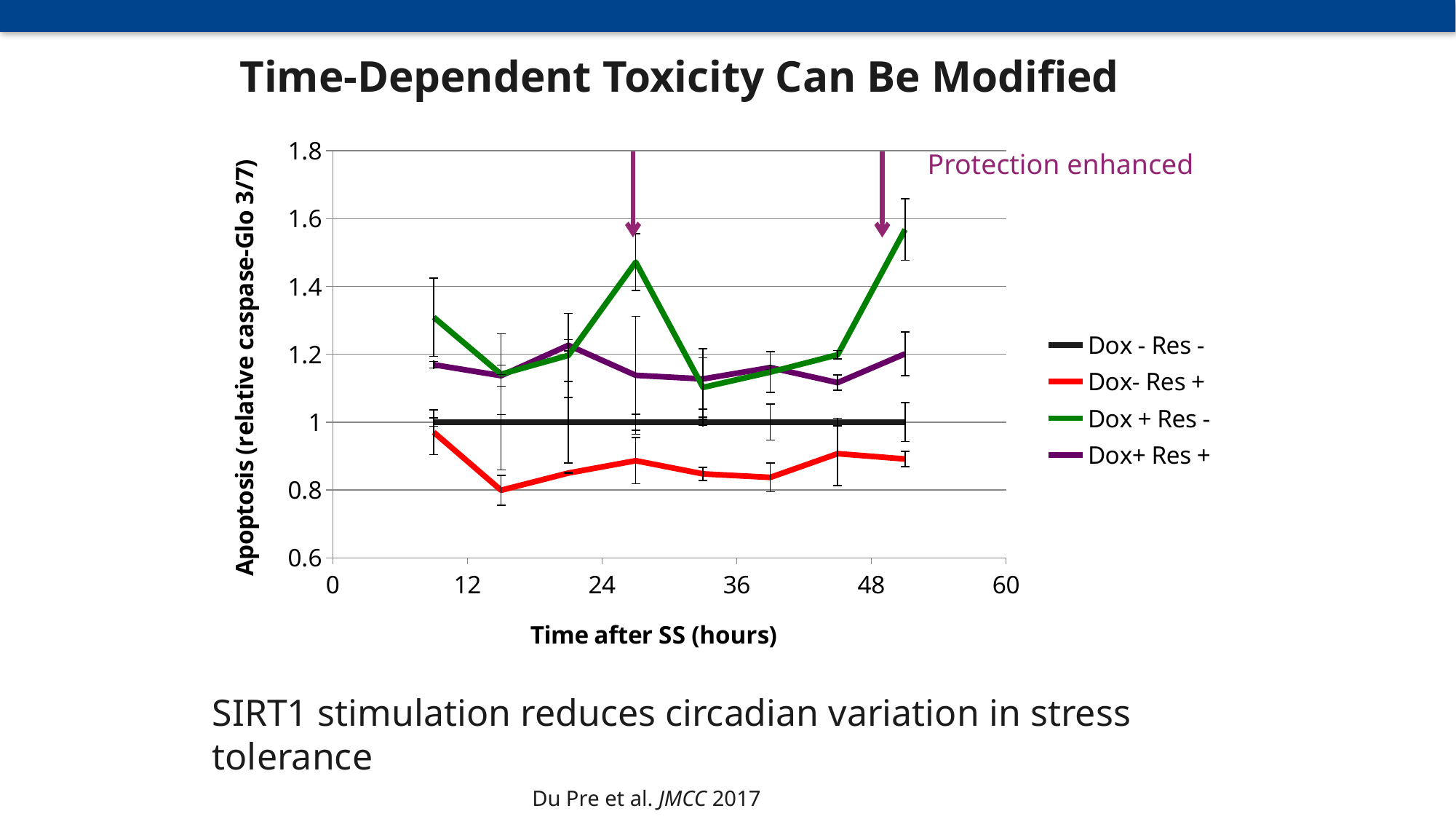
Which series reaches the highest apoptosis value on the chart? Dox + Res - Does the Dox + Res - series rise or fall between about 27 hours and about 33 hours? fall At what constant value does the Dox - Res - series run across the chart? 1 What kind of chart is shown on the slide? line chart How many series does the legend list? 4 Is the peak value of the Dox + Res - series at about 27 hours greater or less than 1.4? greater What is the title of the x axis? Time after SS (hours) At about 27 hours, which series has the larger value, Dox + Res - or Dox+ Res +? Dox + Res - Is the value of the Dox + Res - series at about 51 hours greater or less than 1.4? greater Which series has the lowest apoptosis values on the chart? Dox- Res + What is the title of the y axis? Apoptosis (relative caspase-Glo 3/7) Are the values of the Dox- Res + series greater or less than 1 throughout the chart? less